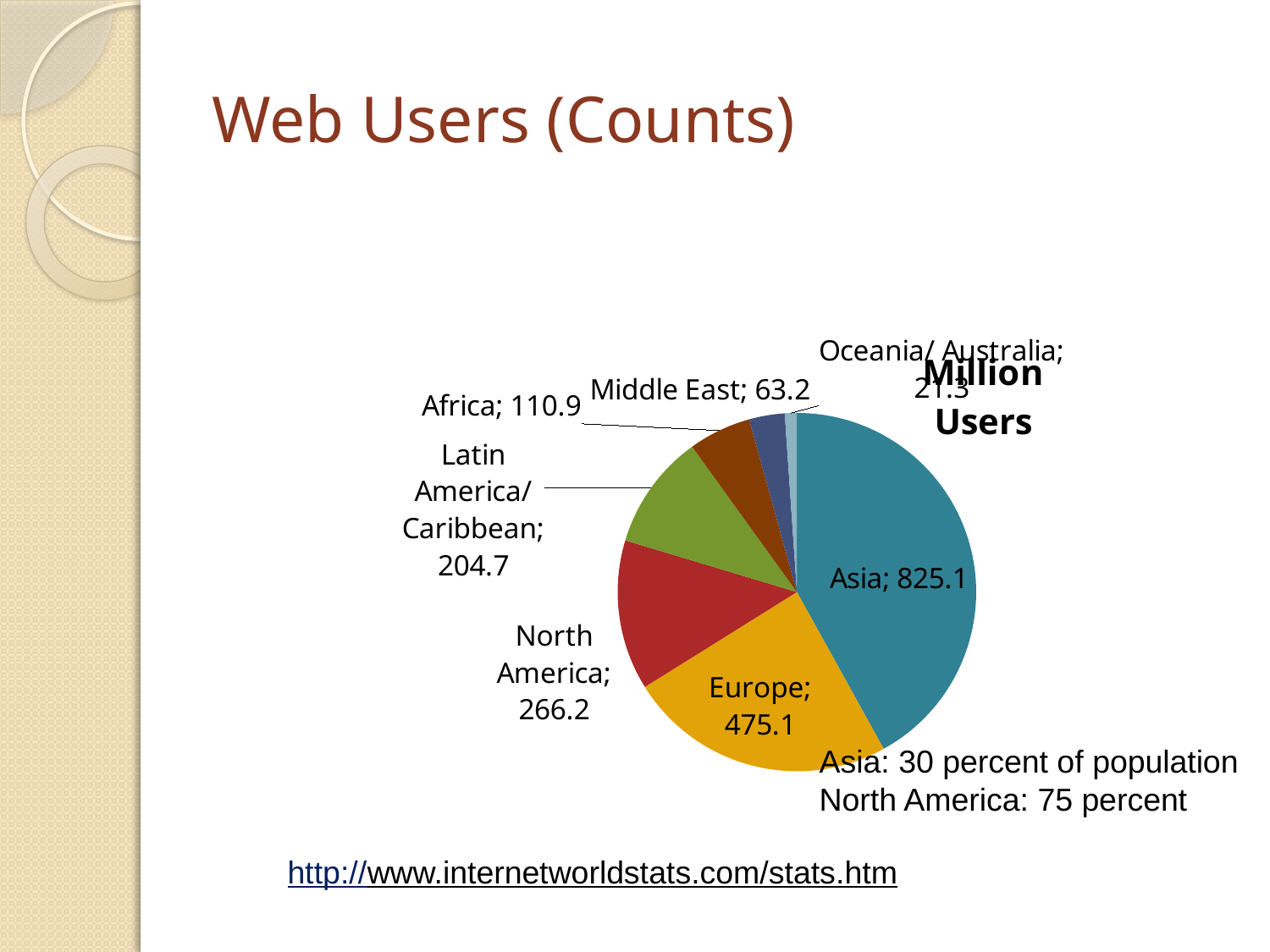
How many slices does the pie chart have? 7 Which region has the largest slice of the pie? Asia Which is larger, the value for North America or the value for Latin America/Caribbean? North America What kind of chart is shown on the slide? pie chart What is the difference between the values for Africa and the Middle East? 47.7 What is the value shown for Europe? 475.1 What is the title shown on the pie chart? Million Users Which region has the smallest slice of the pie? Oceania/Australia What is the value shown for Latin America/Caribbean? 204.7 What is the value shown for Oceania/Australia? 21.3 What is the difference between the values for Asia and Europe? 350.0 What is the value shown for Asia? 825.1